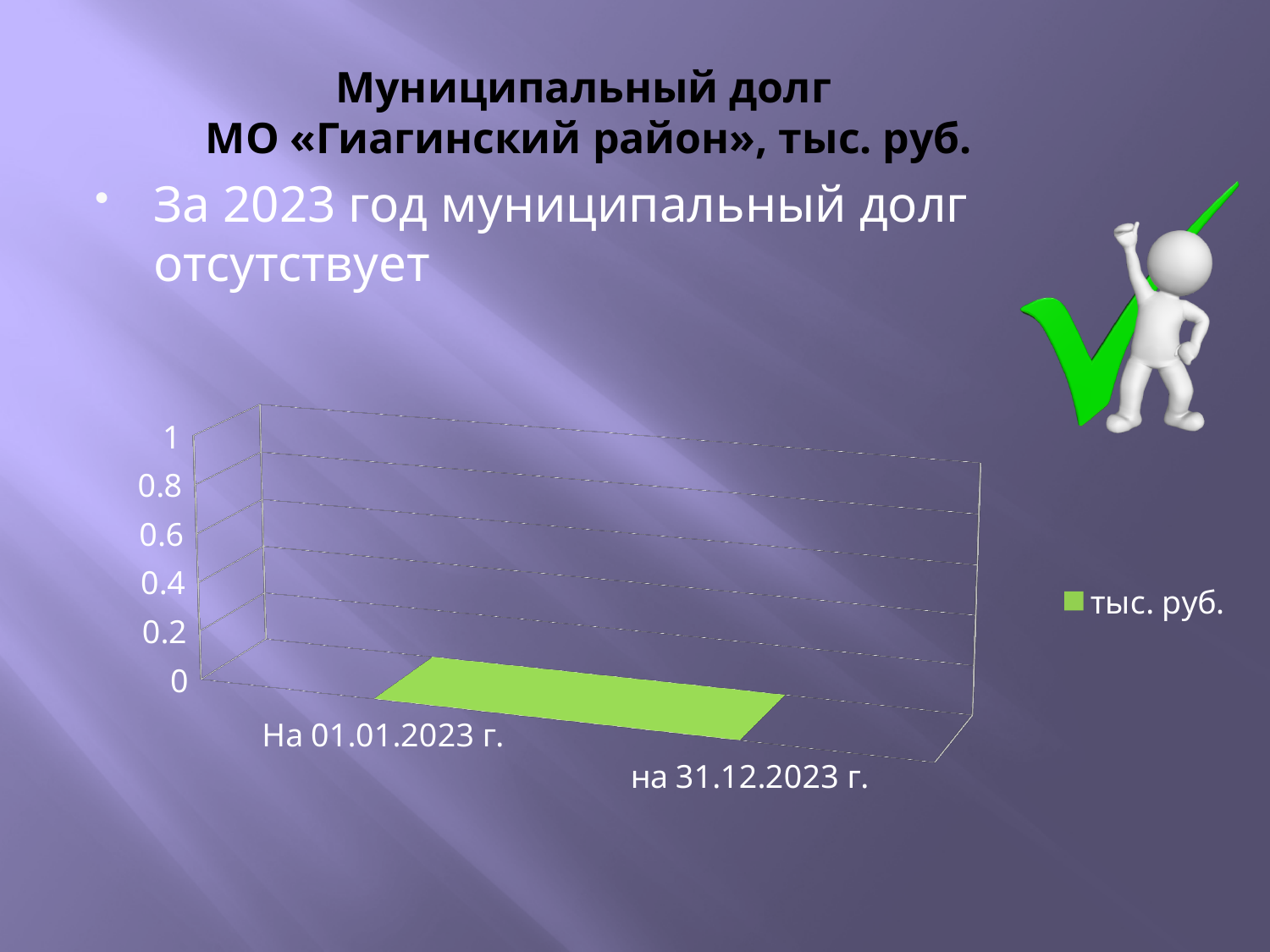
How many categories are shown on the x axis of the chart? 2 What is the highest tick value shown on the vertical axis of the chart? 1 Is the value for "На 01.01.2023 г." greater or less than 0.4? less Is the value for "на 31.12.2023 г." greater or less than 0.2? less What is the legend entry of the chart? тыс. руб. What kind of chart is shown on the slide? line chart Do the values rise, fall or stay flat from 01.01.2023 to 31.12.2023? stay flat What is the value of municipal debt for "На 01.01.2023 г."? 0 How many series does the chart legend list? 1 What is the value of municipal debt for "на 31.12.2023 г."? 0 What are the two category labels on the x axis of the chart? На 01.01.2023 г. and на 31.12.2023 г.